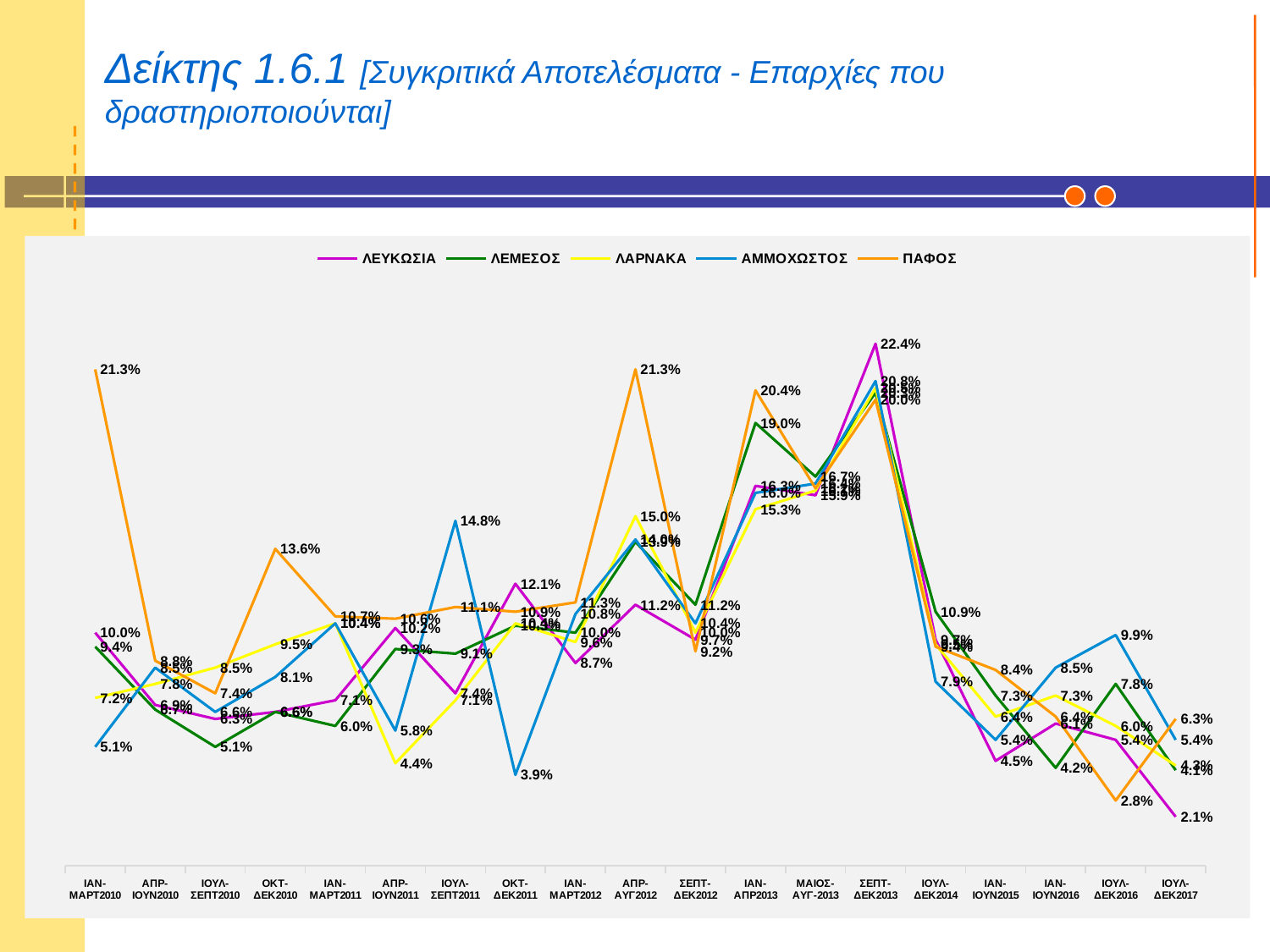
Which series has the lowest value in ΙΟΥΛ-ΔΕΚ2017? ΛΕΥΚΩΣΙΑ How many series does the legend list? 5 In ΙΟΥΛ-ΔΕΚ2016, which is larger: ΑΜΜΟΧΩΣΤΟΣ or ΠΑΦΟΣ? ΑΜΜΟΧΩΣΤΟΣ What is the value for ΠΑΦΟΣ in ΙΑΝ-ΜΑΡΤ2010? 21.3% What is the value for ΛΕΥΚΩΣΙΑ in ΣΕΠΤ-ΔΕΚ2013? 22.4% What is the value for ΛΑΡΝΑΚΑ in ΑΠΡ-ΙΟΥΝ2011? 4.4% What type of chart is shown on the slide? Line chart Does the ΛΕΥΚΩΣΙΑ line rise or fall from ΣΕΠΤ-ΔΕΚ2013 to ΙΟΥΛ-ΔΕΚ2017? Fall How many time periods are shown along the x axis? 19 What is the value for ΑΜΜΟΧΩΣΤΟΣ in ΟΚΤ-ΔΕΚ2011? 3.9% What is the difference between ΠΑΦΟΣ and ΛΕΜΕΣΟΣ in ΙΑΝ-ΑΠΡ2013? 1.4 percentage points Which series has the highest value in ΣΕΠΤ-ΔΕΚ2013? ΛΕΥΚΩΣΙΑ